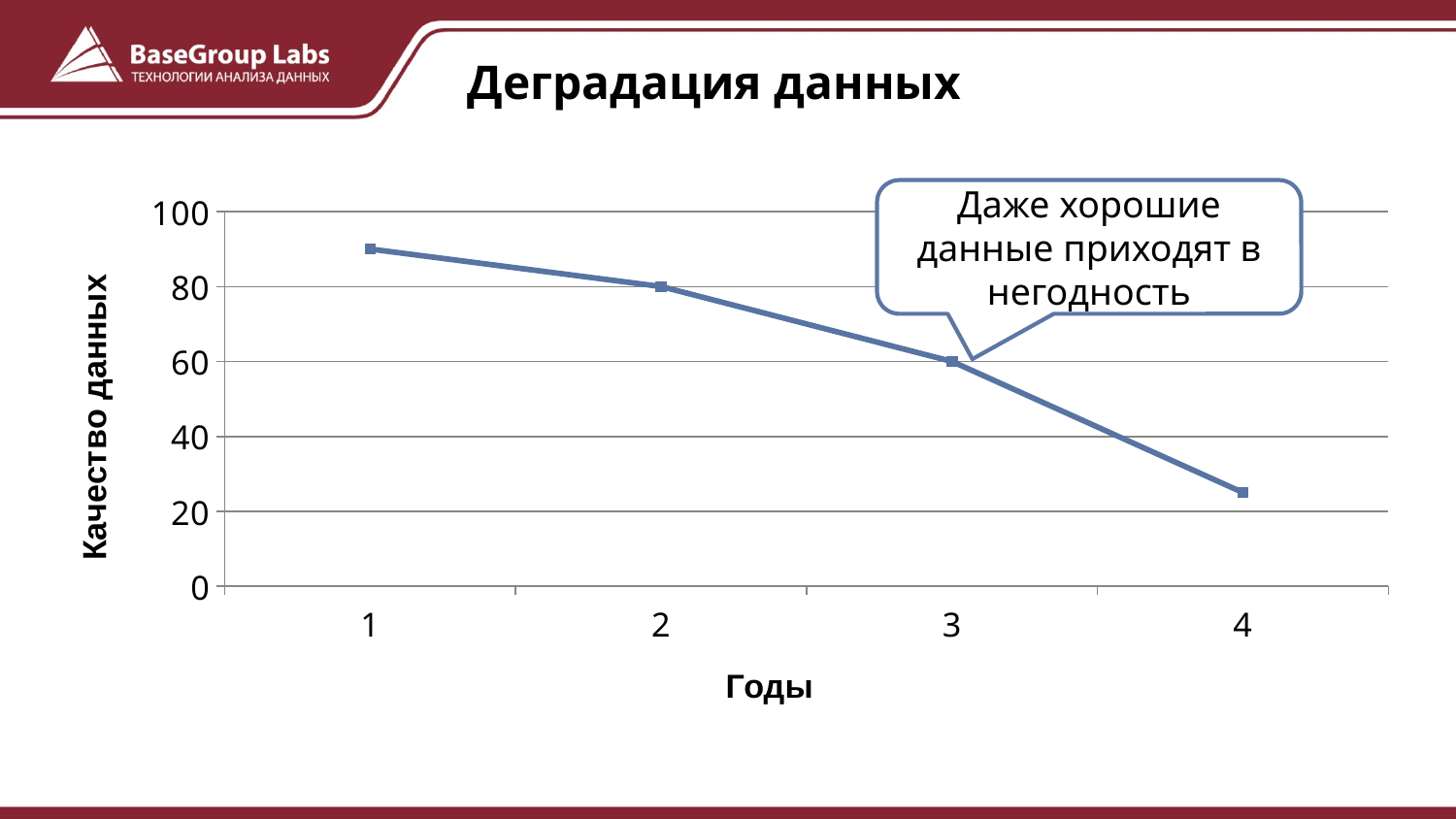
What is the value of Качество данных at year 2? 80 By how much does Качество данных drop between year 2 and year 3? 20 Is the value for year 4 greater or less than 40? less How many data points are plotted on the line? 4 Do the values rise or fall as the years increase along the x axis? fall Is the value for year 4 greater or less than 20? greater Is the value for year 1 greater or less than 80? greater Which is larger, the value at year 1 or the value at year 4? year 1 Which year has the highest value of Качество данных? 1 What is the value of Качество данных at year 3? 60 What kind of chart is shown on the slide? line chart Which year has the lowest value of Качество данных? 4